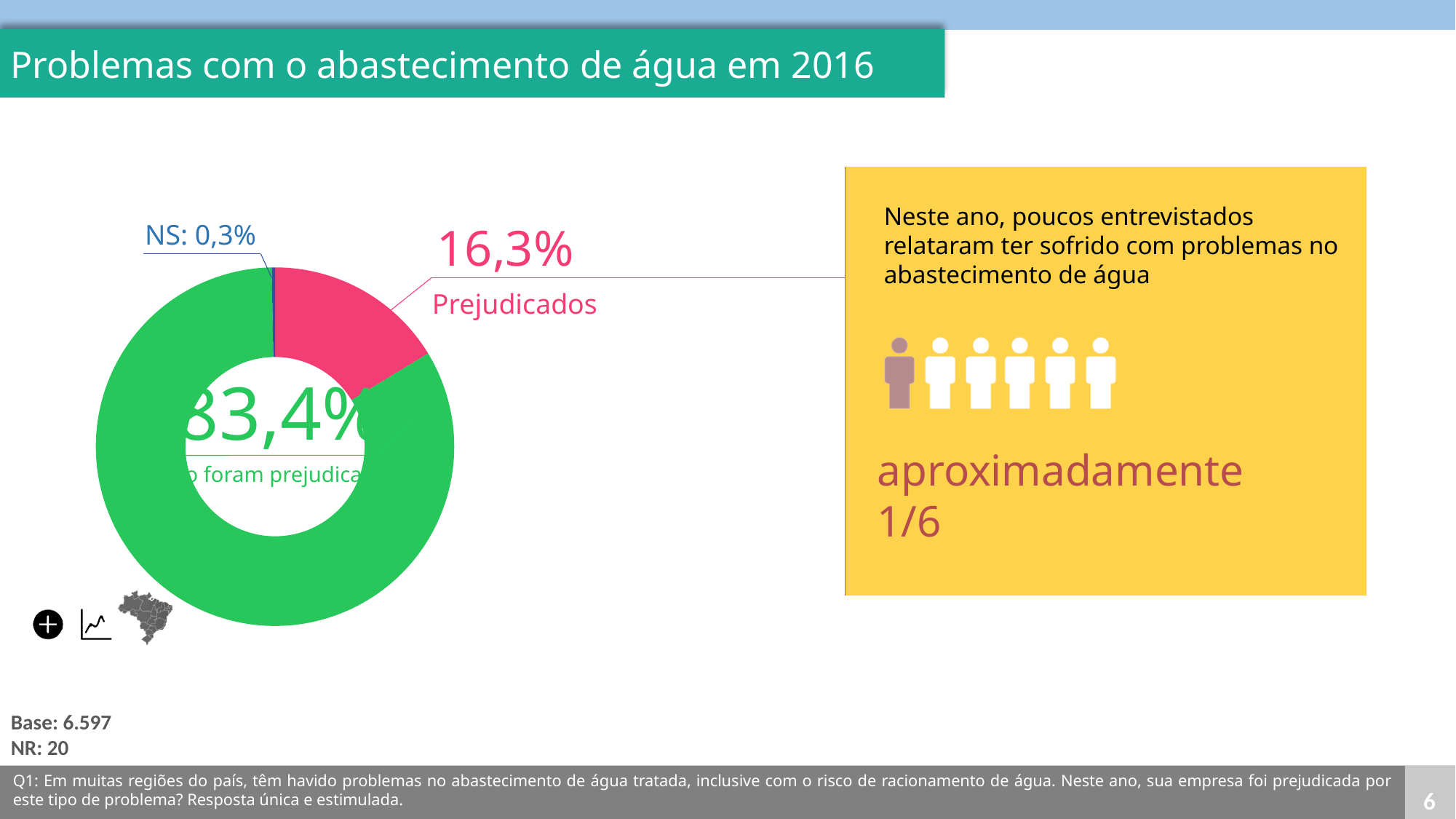
What is the title of the slide containing the chart? Problemas com o abastecimento de água em 2016 What is the difference between the "Prejudicados" slice (16,3%) and the "NS" slice (0,3%)? 16,0 percentage points What kind of chart is shown on the slide? Pie chart (donut) Which is larger, the "Prejudicados" slice or the "NS" slice? Prejudicados Which slice of the chart is the smallest? NS (0,3%) What is the value shown for "NS" in the chart? 0,3% What percentage is shown in the centre of the donut chart for the green slice? 83,4% What colour is the "Prejudicados" slice in the chart? Pink What percentage of respondents are labelled "Prejudicados" in the chart? 16,3% Which slice of the chart is the largest? The green slice (83,4%) What is the difference between the green slice (83,4%) and the "Prejudicados" slice (16,3%)? 67,1 percentage points How many slices does the donut chart have? 3